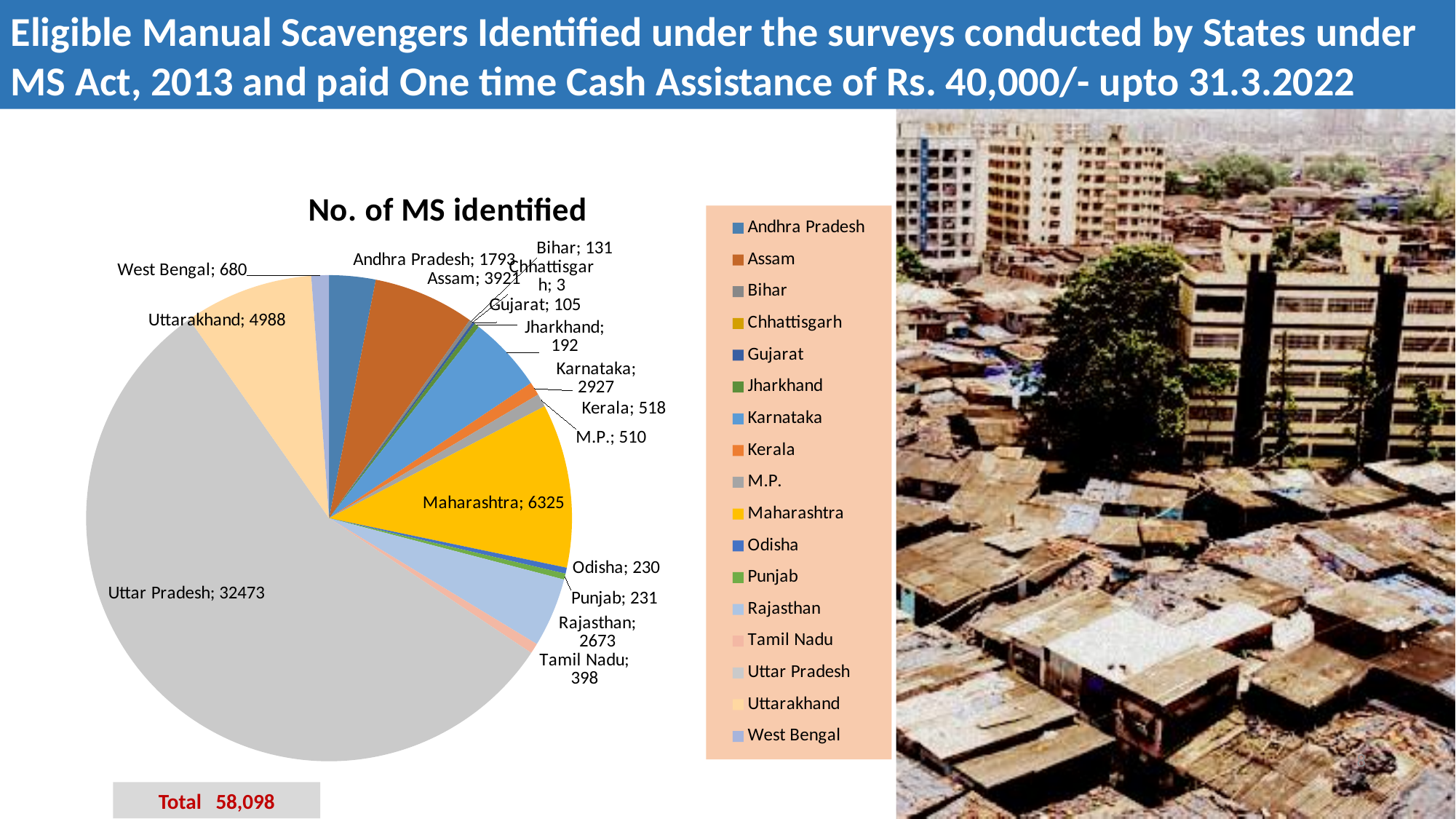
What is the number of MS identified for Karnataka? 2927 What is the title of the chart? No. of MS identified How many states are shown as slices in the pie chart? 17 What is the number of MS identified for Maharashtra? 6325 Which state has the largest slice in the pie chart? Uttar Pradesh Which is larger, the value for Assam or the value for Karnataka? Assam What is the number of MS identified for Chhattisgarh? 3 What is the difference between the values for Maharashtra and Uttarakhand? 1337 What total is shown below the pie chart? 58,098 What is the number of MS identified for Uttar Pradesh? 32473 What kind of chart is shown on the slide? pie chart Which state has the smallest value in the pie chart? Chhattisgarh